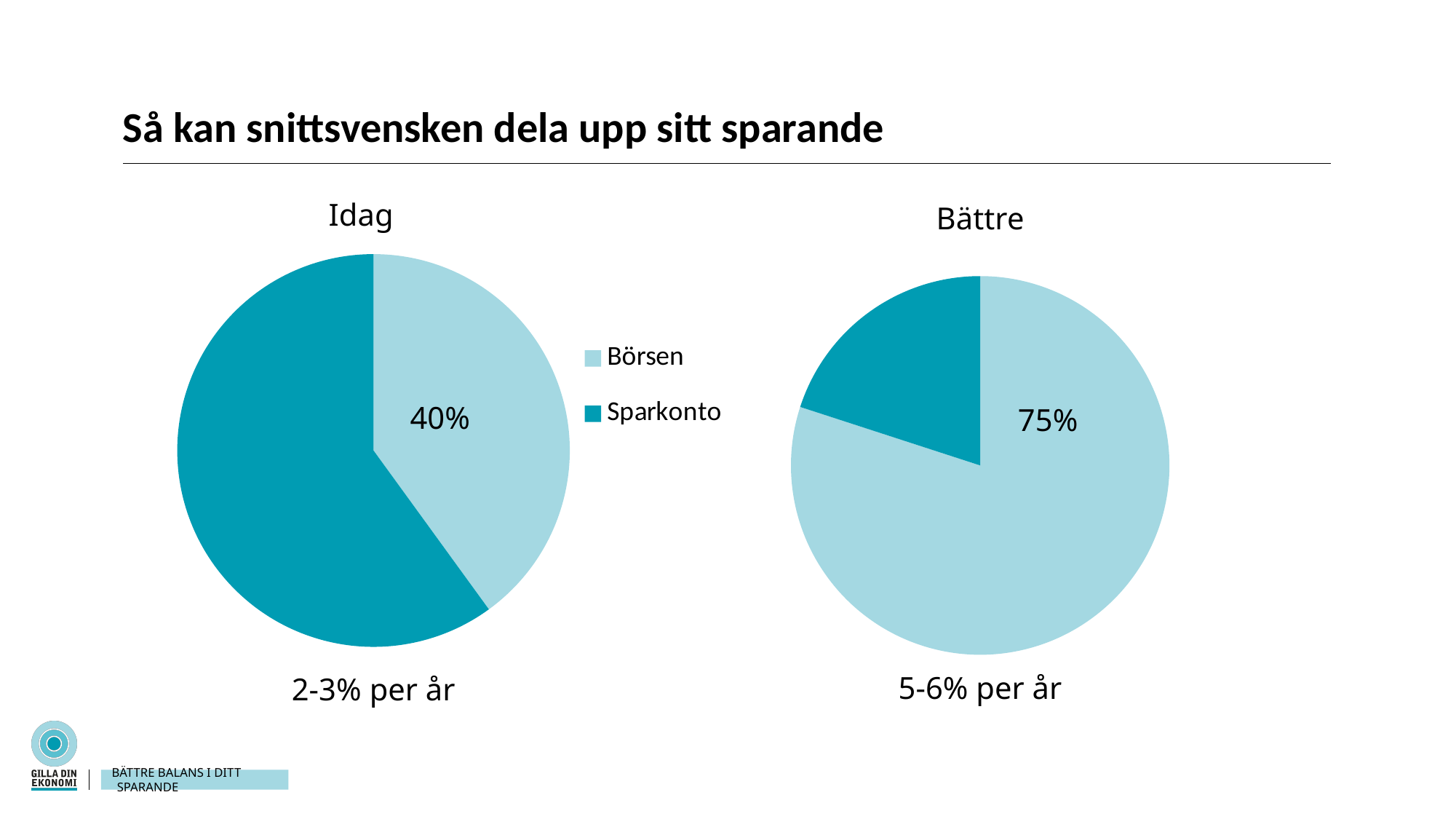
In the "Idag" pie chart, what share does the Börsen slice have? 40% In the "Idag" pie chart, which category has the largest slice? Sparkonto What annual return text is shown below the "Bättre" pie chart? 5-6% per år How many entries does the legend between the two pie charts list? 2 What is the title of the slide containing the two pie charts? Så kan snittsvensken dela upp sitt sparande How many slices does the "Bättre" pie chart have? 2 In the "Idag" pie chart, which slice is larger, Börsen or Sparkonto? Sparkonto What kind of chart is the "Idag" chart? Pie chart In the "Bättre" pie chart, which slice is larger, Börsen or Sparkonto? Börsen In the "Bättre" pie chart, which category has the smallest slice? Sparkonto Is the Börsen share in the "Bättre" pie chart greater or less than the Börsen share in the "Idag" pie chart? greater In the "Bättre" pie chart, what share does the Börsen slice have? 75%